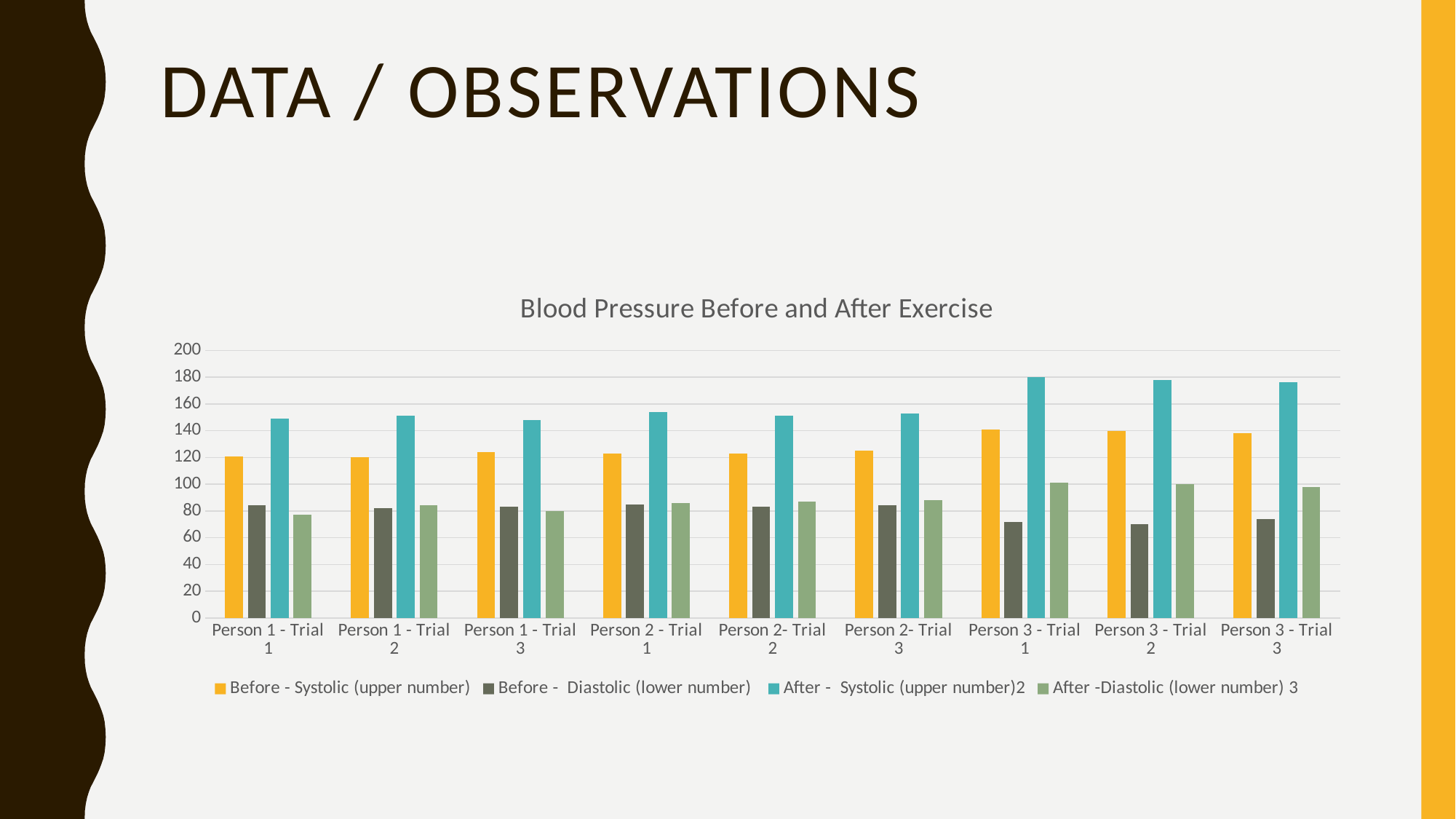
Which is larger: the After - Systolic (upper number)2 value for Person 3 - Trial 1 or for Person 1 - Trial 1? Person 3 - Trial 1 Is the After - Systolic (upper number)2 value for Person 3 - Trial 1 greater or less than 160? greater What is the title of the chart? Blood Pressure Before and After Exercise What is the highest value shown on the y axis? 200 Is the After -Diastolic (lower number) 3 value for Person 1 - Trial 2 greater or less than 100? less Is the After - Systolic (upper number)2 value for Person 1 - Trial 1 greater or less than 140? greater What type of chart is shown on the slide? bar chart How many categories are shown on the x axis? 9 For Person 1 - Trial 1, which is larger: the Before - Systolic (upper number) value or the After - Systolic (upper number)2 value? After - Systolic (upper number)2 For Person 3 - Trial 1, which is larger: the Before - Diastolic (lower number) value or the After -Diastolic (lower number) 3 value? After -Diastolic (lower number) 3 How many series does the legend list? 4